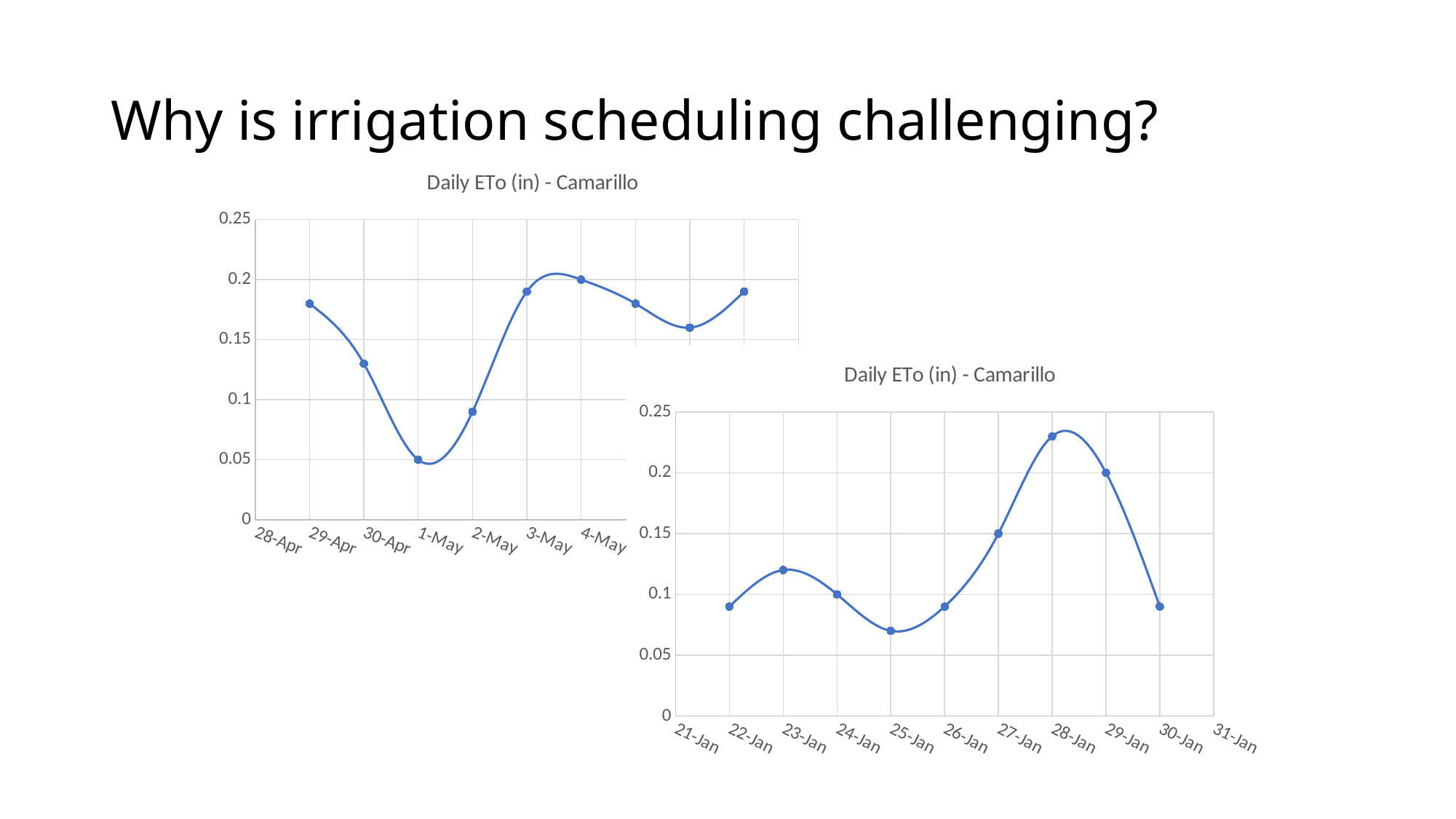
In the top-left chart, which date has the lowest value? 1-May What type of chart is the top-left chart on the slide? Line chart In the bottom-right chart, do the values rise or fall from 25-Jan to 28-Jan? rise In the bottom-right chart, which date has the highest value? 28-Jan In the top-left chart, what is the value for 4-May? 0.2 In the bottom-right chart, which date has the lowest value? 25-Jan What is the title of the bottom-right chart? Daily ETo (in) - Camarillo In the top-left chart, is the value for 29-Apr greater or less than 0.15? greater In the top-left chart, what is the value for 1-May? 0.05 In the bottom-right chart, what is the value for 24-Jan? 0.1 In the top-left chart, is the value for 2-May greater or less than 0.1? less In the bottom-right chart, what is the value for 29-Jan? 0.2